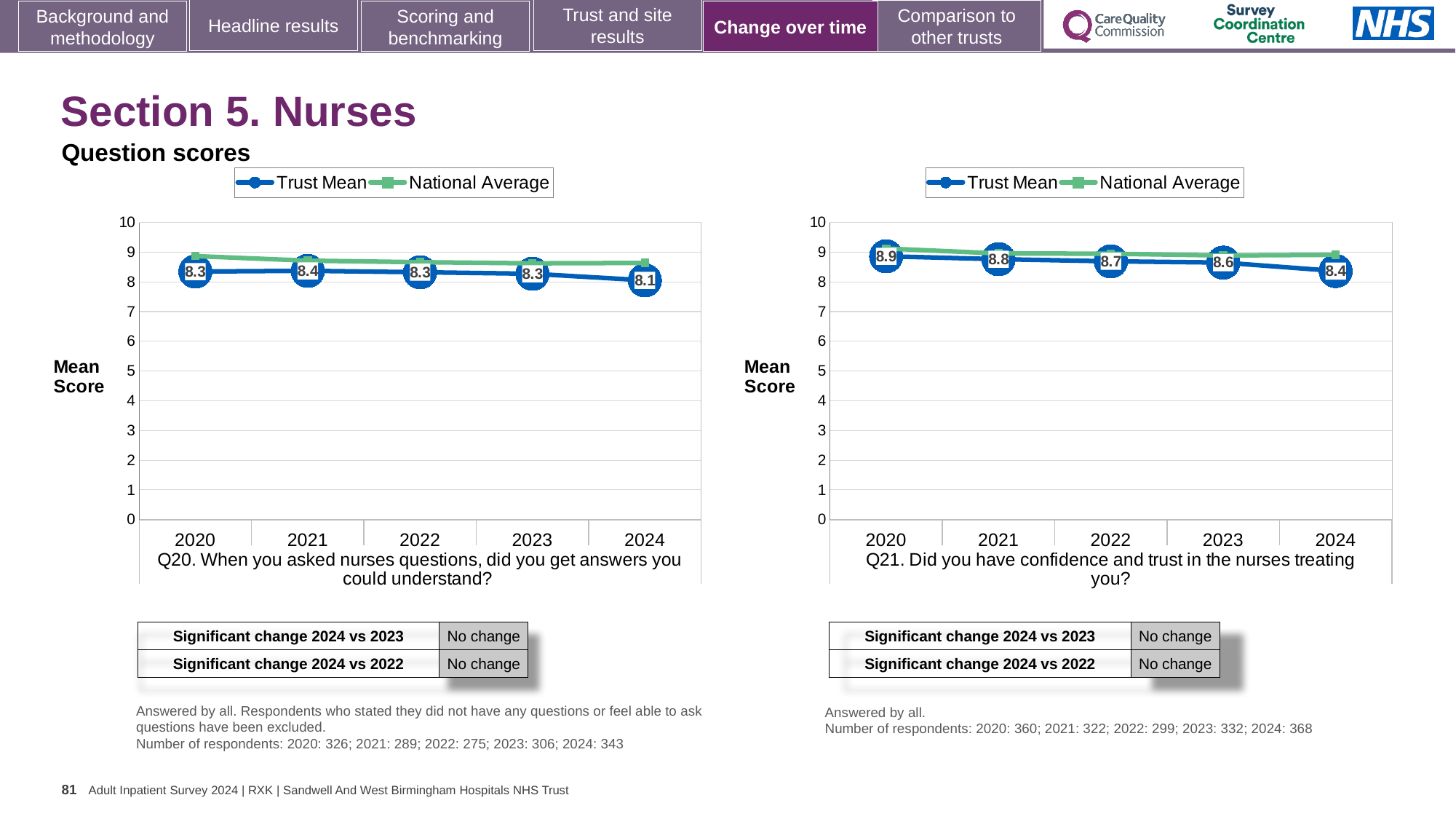
How many series does the legend of the Q20 chart (left) list? 2 On the Q21 chart (right), what is the Trust Mean for 2023? 8.6 How many years are plotted on the Q21 chart (right)? 5 What kind of chart is the Q21 chart (right)? Line chart On the Q20 chart (left), is the National Average for 2020 greater or less than 8? greater On the Q21 chart (right), what is the difference between the Trust Mean in 2020 and in 2024? 0.5 On the Q20 chart (left), which year has the lowest Trust Mean? 2024 On the Q20 chart (left), what is the Trust Mean for 2021? 8.4 On the Q20 chart (left), what is the Trust Mean for 2024? 8.1 On the Q21 chart (right), which year has the highest Trust Mean? 2020 On the Q21 chart (right), what is the Trust Mean for 2020? 8.9 On the Q20 chart (left), is the Trust Mean for 2021 or for 2024 larger? 2021